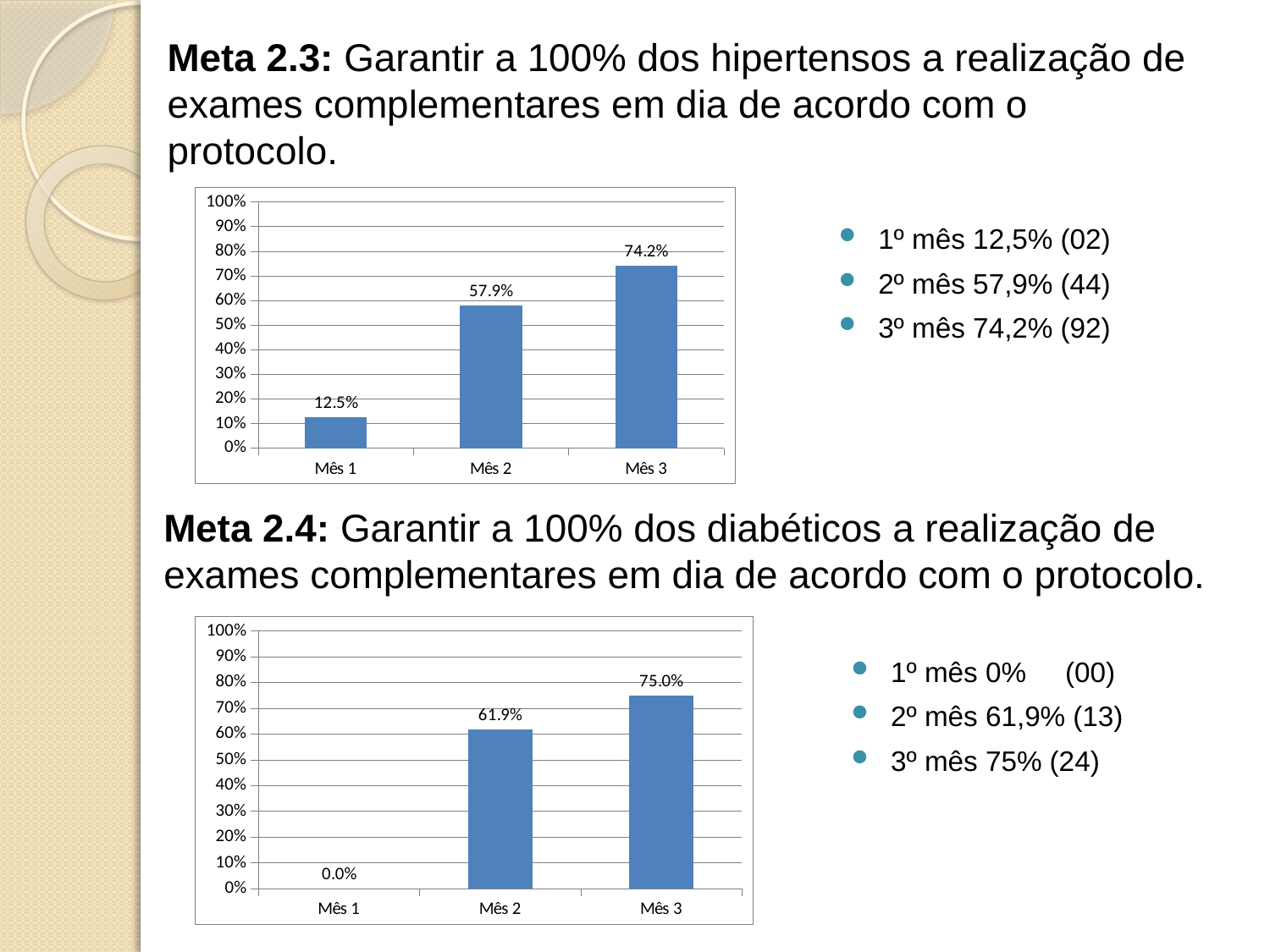
In the top chart (Meta 2.3), which month has the highest value? Mês 3 In the top chart (Meta 2.3), what is the value for Mês 1? 12.5% In the top chart (Meta 2.3), is the value for Mês 3 greater or less than 70%? greater In the bottom chart (Meta 2.4), what is the value for Mês 2? 61.9% In the bottom chart (Meta 2.4), which month has the lowest value? Mês 1 In the bottom chart (Meta 2.4), what is the difference between Mês 3 and Mês 2? 13.1% In the bottom chart (Meta 2.4), how many categories are shown on the x axis? 3 In the top chart (Meta 2.3), do the values rise or fall from Mês 1 to Mês 3? rise In the bottom chart (Meta 2.4), what is the value for Mês 1? 0.0% In the top chart (Meta 2.3), what is the value for Mês 2? 57.9% In the top chart (Meta 2.3), what is the difference between Mês 3 and Mês 1? 61.7% What type of chart is the bottom chart (Meta 2.4)? bar chart